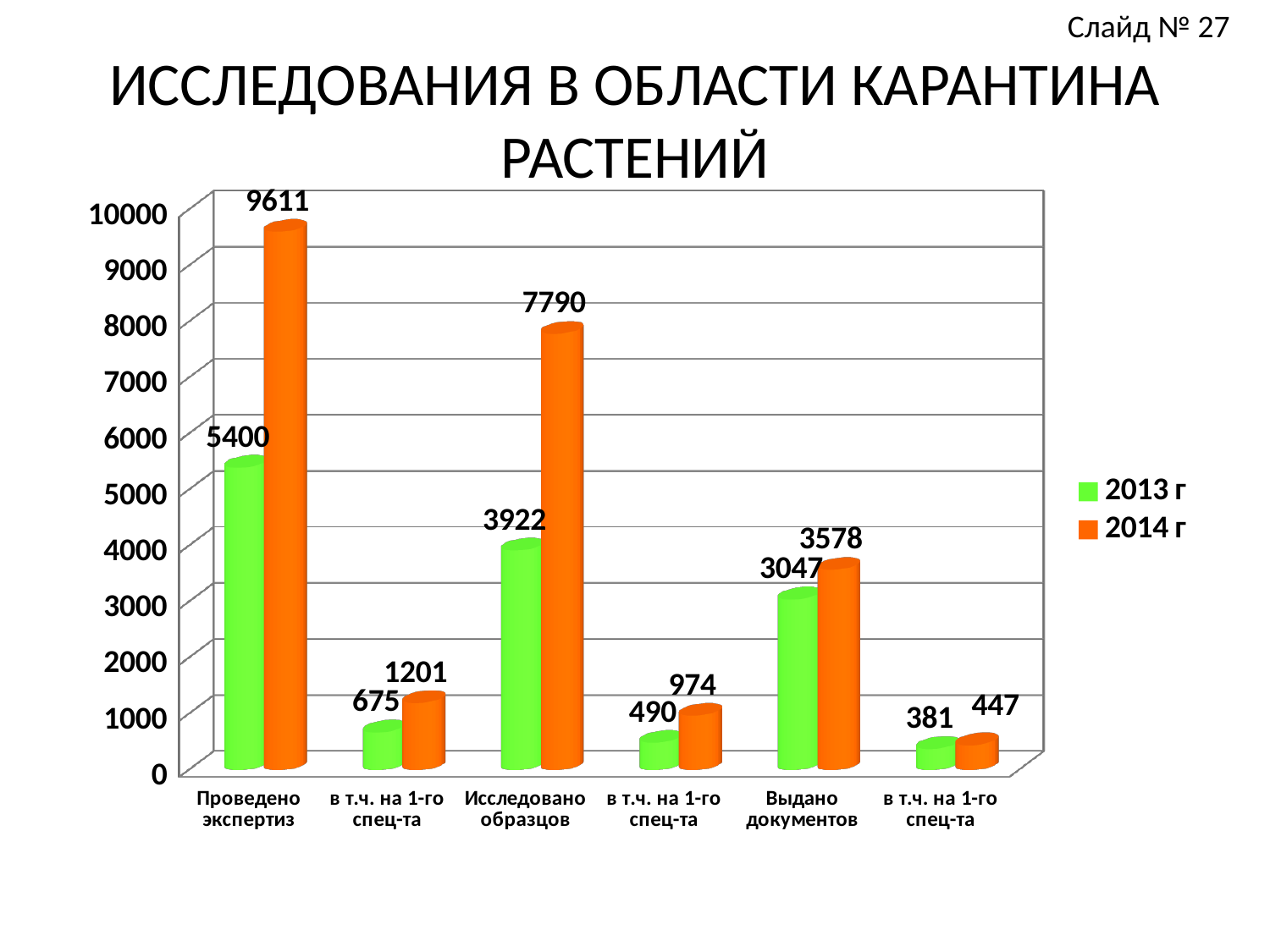
Which category has the lowest value in the 2013 г series? в т.ч. на 1-го спец-та (after Выдано документов) What kind of chart is shown on the slide? Bar chart What is the 2014 г value for "Выдано документов"? 3578 What is the value for "Проведено экспертиз" in the 2014 г series? 9611 What is the value for "Исследовано образцов" in the 2013 г series? 3922 What is the 2013 г value for the "в т.ч. на 1-го спец-та" category that follows "Исследовано образцов"? 490 How many categories are shown on the x axis? 6 What is the difference between the 2014 г and 2013 г values for "Выдано документов"? 531 How many series does the legend list? 2 What is the difference between the 2014 г and 2013 г values for "Проведено экспертиз"? 4211 Which is larger: the 2013 г value for "Исследовано образцов" or the 2014 г value for "Выдано документов"? 2013 г value for Исследовано образцов (3922) Which category has the highest value in the 2014 г series? Проведено экспертиз